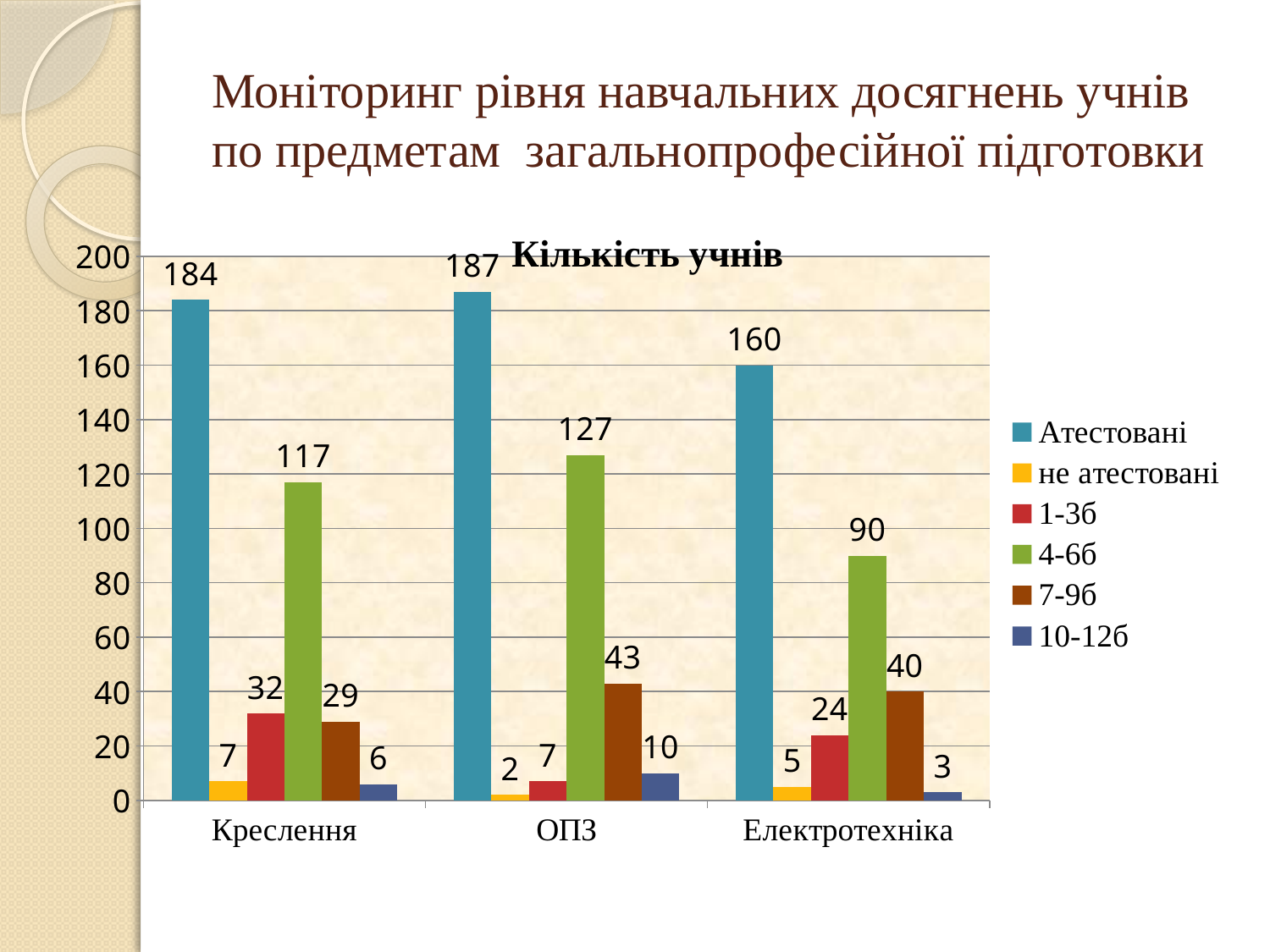
What is the value of 7-9б for Електротехніка? 40 What is the value of не атестовані for ОПЗ? 2 What kind of chart is shown on the slide? Bar chart Which category has the lowest value for 10-12б? Електротехніка Which is larger: the 1-3б value for Креслення or the 1-3б value for Електротехніка? Креслення What is the value of 4-6б for ОПЗ? 127 How many series does the legend list? 6 What is the title of the chart? Кількість учнів How many categories are shown on the x axis? 3 What is the value of Атестовані for Креслення? 184 Which category has the highest value for Атестовані? ОПЗ What is the difference between the Атестовані values for ОПЗ and Електротехніка? 27